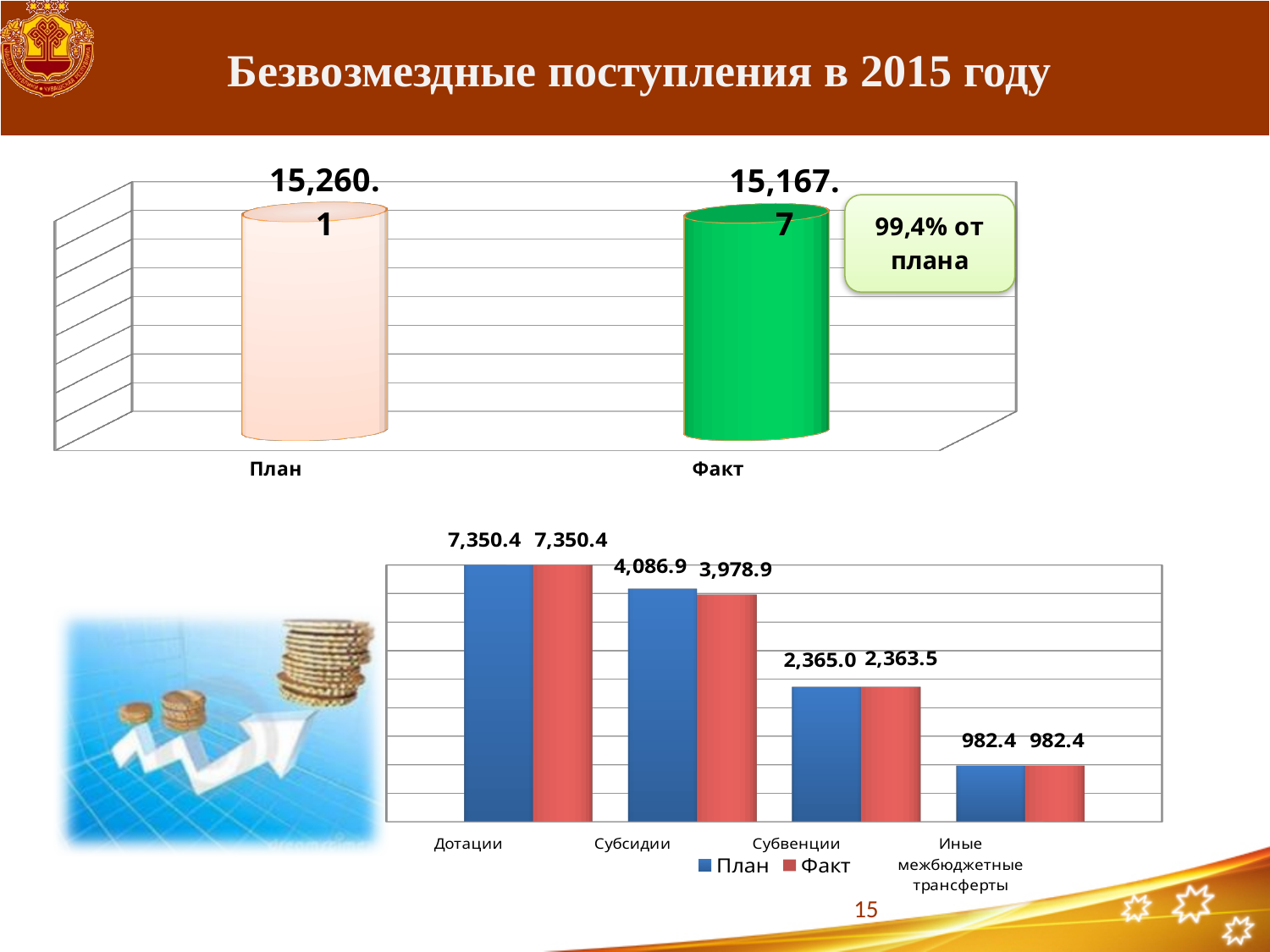
How many series does the legend of the bottom chart list? 2 In the top chart, what percentage of the plan does the callout say was achieved? 99,4% от плана In the bottom chart, do the План values rise or fall from left to right along the x axis? fall How many categories are shown on the x axis of the bottom chart? 4 In the top chart, what is the value for Факт? 15,167.7 In the top chart, what is the value for План? 15,260.1 In the bottom chart, what is the План value for Субвенции? 2,365.0 In the top chart, what is the difference between the План and Факт values? 92.4 In the bottom chart, what is the difference between the План and Факт values for Субсидии? 108.0 What kind of chart is the bottom chart? bar chart In the bottom chart, which category has the highest План value? Дотации In the bottom chart, what is the Факт value for Субсидии? 3,978.9